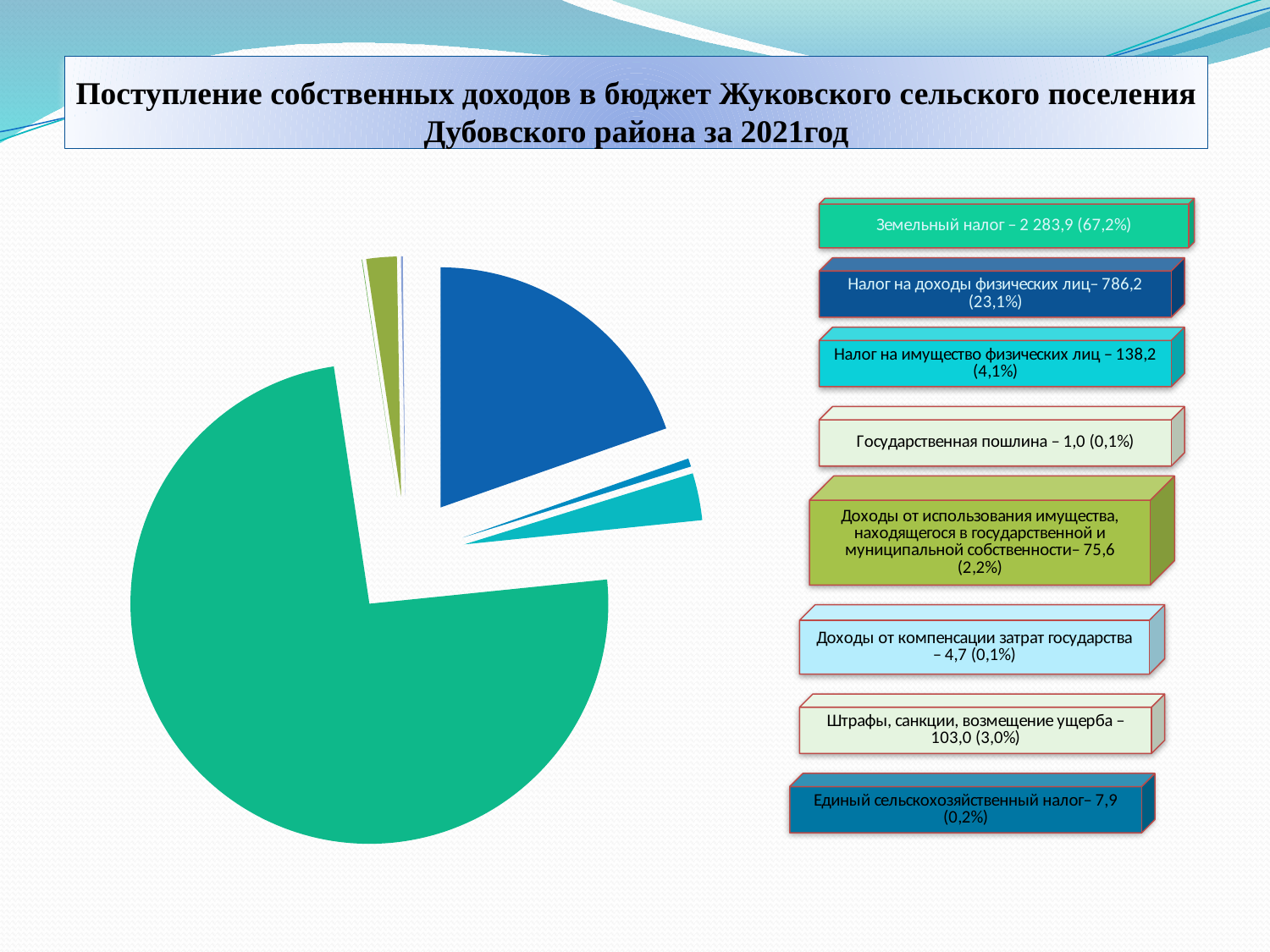
Which category has the highest value? Земельный налог What share of the pie does Налог на доходы физических лиц represent? 23,1% What is the value for Земельный налог? 2 283,9 Which category has the lowest value? Государственная пошлина Which is larger: Налог на имущество физических лиц or Штрафы, санкции, возмещение ущерба? Налог на имущество физических лиц What is the value for Штрафы, санкции, возмещение ущерба? 103,0 What share of the pie does Земельный налог represent? 67,2% What type of chart is shown on the slide? Pie chart What is the title of the slide? Поступление собственных доходов в бюджет Жуковского сельского поселения Дубовского района за 2021год What is the value for Единый сельскохозяйственный налог? 7,9 What is the difference between Налог на доходы физических лиц and Налог на имущество физических лиц? 648,0 How many categories does the legend list? 8